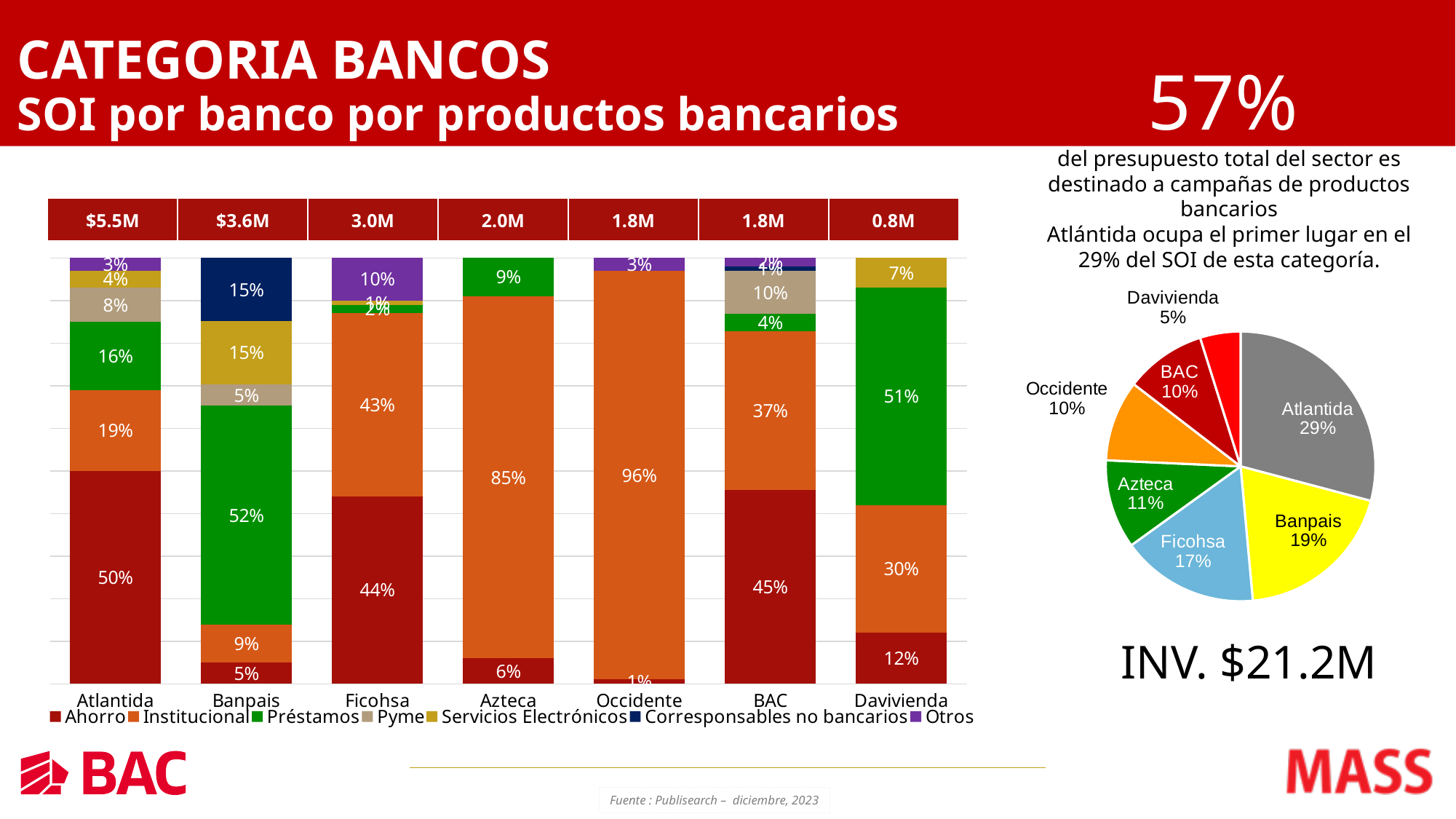
In the pie chart, what share does Atlantida have? 29% In the stacked bar chart, which bank has the lowest Ahorro share? Occidente In the stacked bar chart, which is larger: the Préstamos share for Banpais or the Préstamos share for Atlantida? Banpais In the pie chart, which bank has the smallest slice? Davivienda In the stacked bar chart, what is the Institucional share for Occidente? 96% In the stacked bar chart, what is the difference between the Ahorro share of BAC and the Ahorro share of Davivienda? 33% How many series does the legend of the stacked bar chart list? 7 In the stacked bar chart, what is the Corresponsables no bancarios share for Banpais? 15% In the stacked bar chart, what is the Préstamos share for Davivienda? 51% How many banks are shown on the x axis of the stacked bar chart? 7 In the stacked bar chart, which bank has the highest Institucional share? Occidente In the stacked bar chart, what is the Ahorro share for Atlantida? 50%